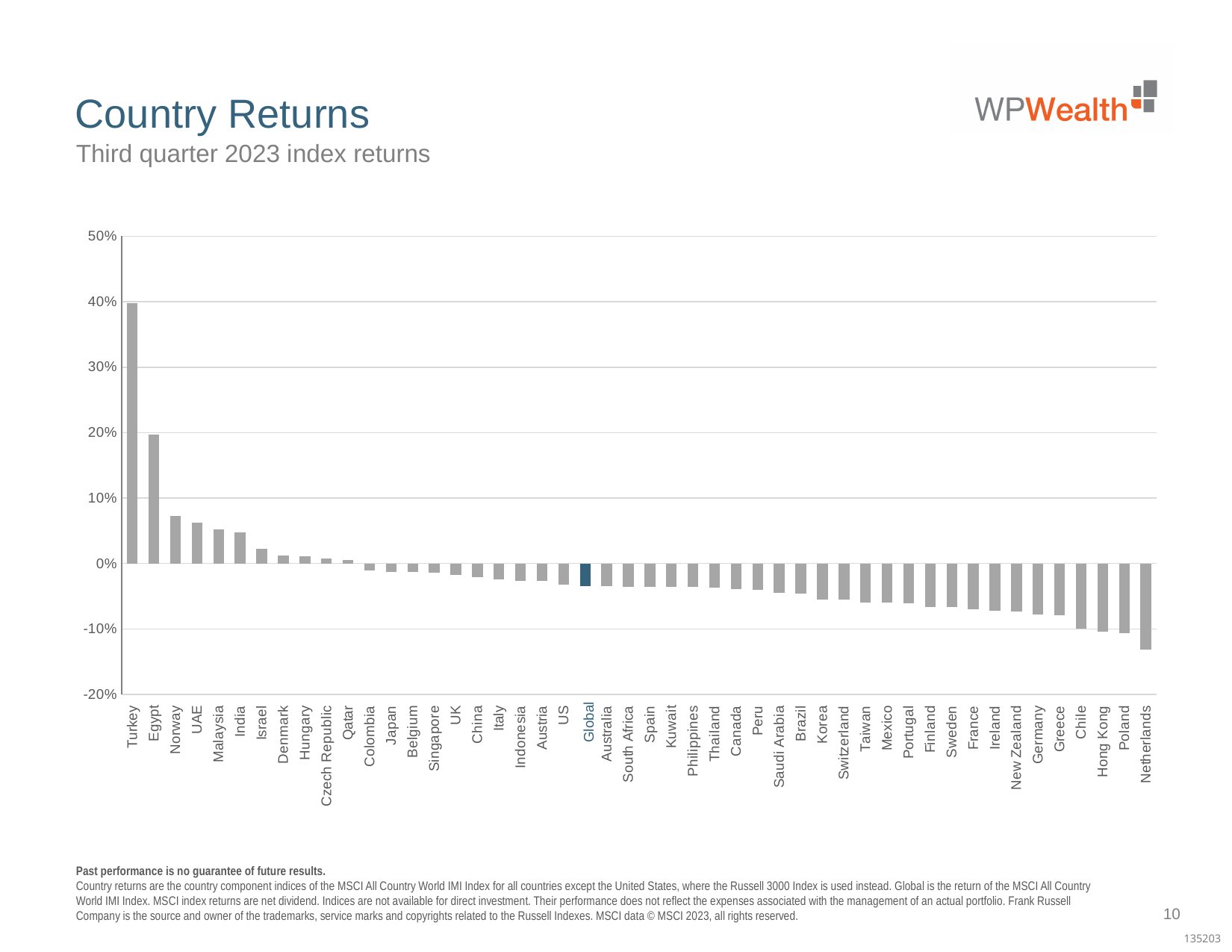
Do the values rise or fall moving from left to right along the x axis? fall Which country has the highest return in the chart? Turkey How many bars (countries plus Global) are plotted in the chart? 48 Which country has the lowest return in the chart? Netherlands Which has the larger return, Turkey or Egypt? Turkey Is the value for Global greater or less than -10%? greater Which has the larger return, India or Israel? India What kind of chart is shown on the slide? bar chart Is the value for Egypt greater or less than 10%? greater Is the value for Turkey greater or less than 30%? greater